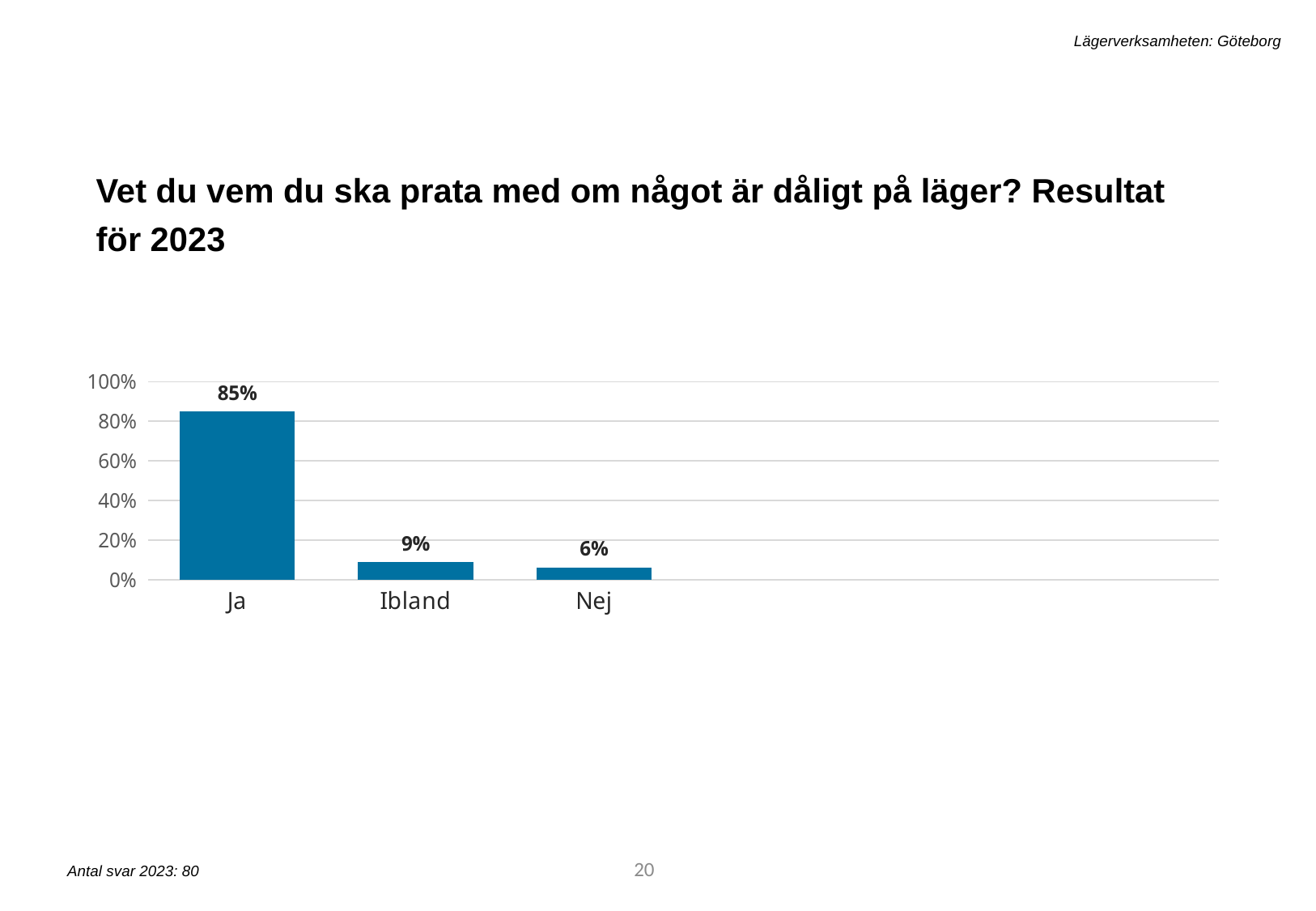
What is the value for Ja? 85% What is the difference between the values for Ja and Ibland? 76% What is the value for Nej? 6% Which category has the highest value? Ja What is the difference between the values for Ibland and Nej? 3% Which is larger, the value for Ibland or the value for Nej? Ibland How many categories are shown on the x axis? 3 What is the number of responses (Antal svar) for 2023 stated on the slide? 80 What kind of chart is shown on the slide? bar chart Which category has the lowest value? Nej What is the value for Ibland? 9% Is the value for Ja greater or less than 80%? greater